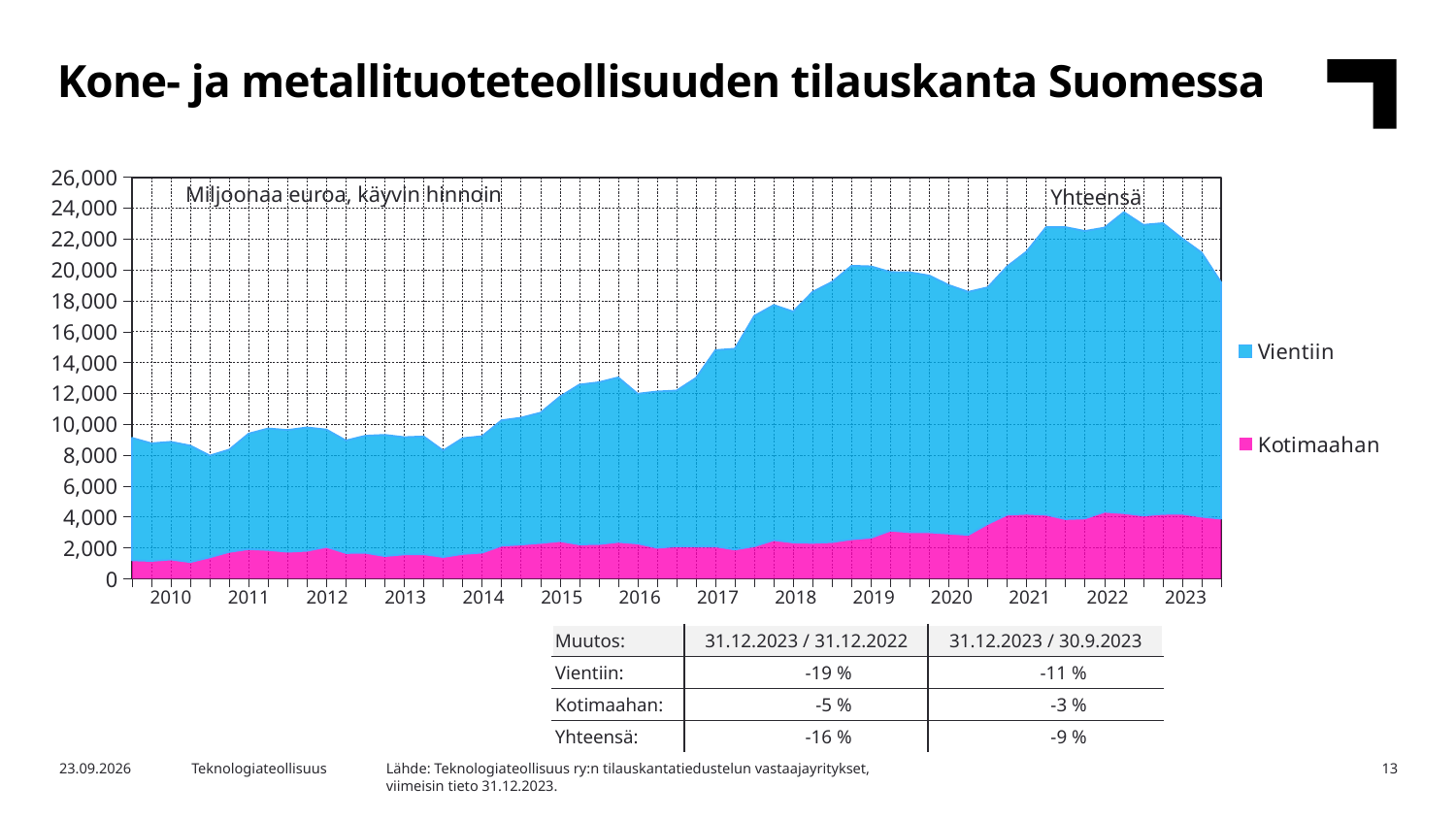
What kind of chart is shown on the slide? Area chart What are the two series named in the chart legend? Vientiin and Kotimaahan Is the total order book at the start of 2010 greater or less than 10,000? less Which series is larger in 2023, Vientiin or Kotimaahan? Vientiin Is the Kotimaahan value in 2021 greater or less than 2,000? greater What unit is stated in the label inside the chart area? Miljoonaa euroa, käyvin hinnoin Is the Kotimaahan value in 2010 greater or less than 2,000? less How many series does the chart legend list? 2 In which year does the total order book (Yhteensä) reach its highest level? 2022 Does the total order book rise or fall overall from 2010 to 2022? rise How many years are labelled on the x axis of the chart? 14